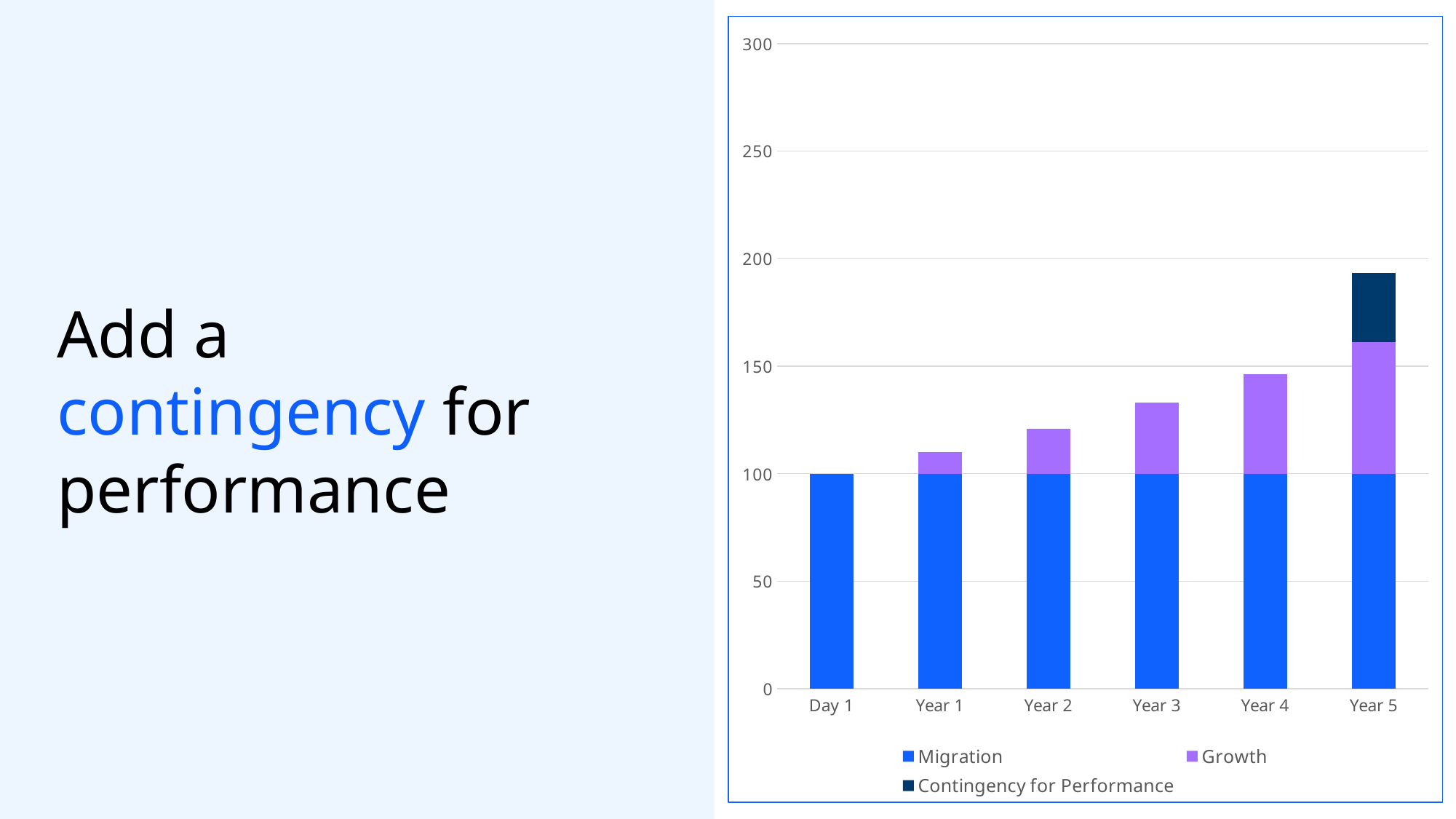
Is the total stacked value for Year 5 greater or less than 200? less Is the total stacked value for Year 1 greater or less than 100? greater Do the stacked bar totals rise or fall from Day 1 to Year 5? rise Which category has the tallest stacked bar? Year 5 What kind of chart is shown on the slide? stacked bar chart How many series does the chart's legend list? 3 Is the total stacked value for Year 3 greater or less than 150? less How many categories are shown on the x axis of the chart? 6 Which category is the only one with a Contingency for Performance segment? Year 5 Which category has the shortest stacked bar? Day 1 What is the Migration value for Day 1? 100 Which series is shown in purple in the legend? Growth